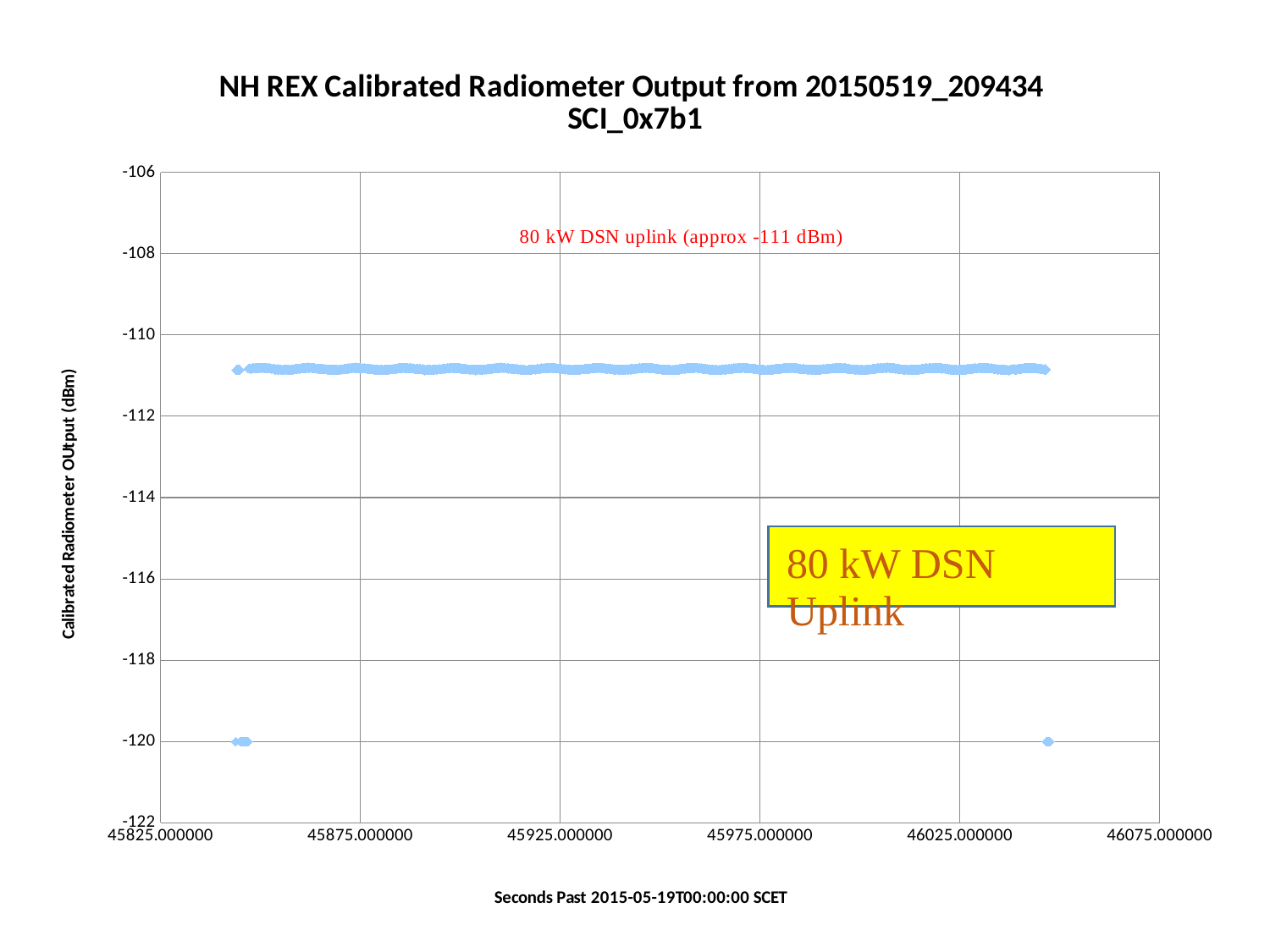
What is the lowest value shown on the vertical axis? -122 What kind of chart is shown on the slide? scatter chart What is the rightmost tick value on the horizontal axis? 46075.000000 According to the red annotation on the chart, what is the approximate level of the 80 kW DSN uplink? approx -111 dBm Do the values in the main band of points rise, fall, or stay roughly flat along the x axis? stay roughly flat Is the main band of plotted points greater or less than -112 on the vertical axis? greater Are the outlying points near the start and end of the data greater or less than -118 on the vertical axis? less Is the main band of plotted points greater or less than -110 on the vertical axis? less